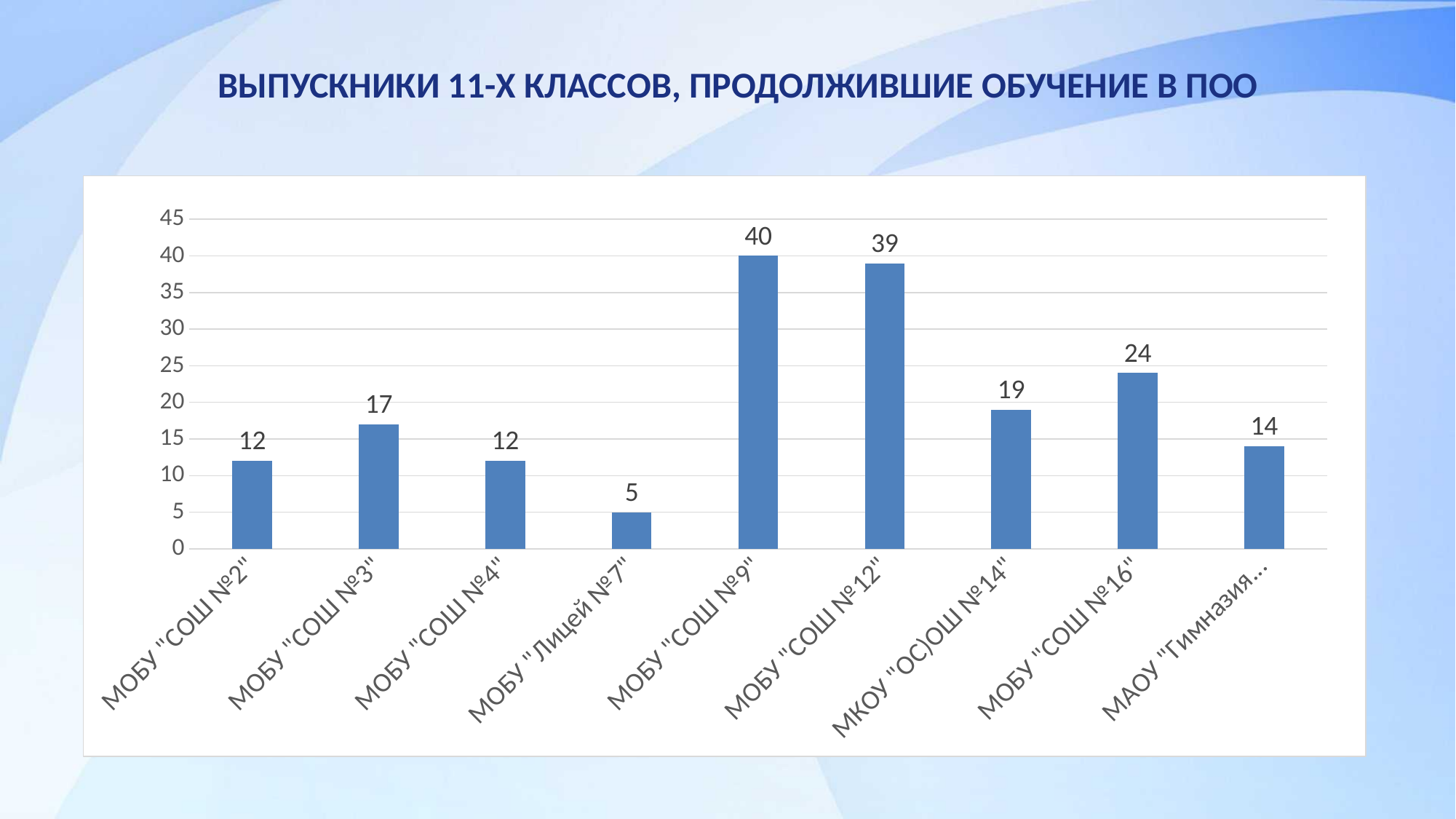
What is the value for МОБУ "СОШ №9"? 40 Which category has the lowest value? МОБУ "Лицей №7" What is the difference between the values for МОБУ "СОШ №9" and МОБУ "СОШ №12"? 1 Which is larger, the value for МОБУ "СОШ №3" or the value for МОБУ "СОШ №4"? МОБУ "СОШ №3" How many categories are shown on the chart? 9 Is the value for МОБУ "СОШ №12" greater or less than 35? greater What kind of chart is shown on the slide? bar chart What is the value for МОБУ "СОШ №16"? 24 What is the value for МОБУ "Лицей №7"? 5 Which category has the highest value? МОБУ "СОШ №9" What is the value for МКОУ "(ОС)ОШ №14"? 19 What is the difference between the values for МОБУ "СОШ №16" and МОБУ "СОШ №3"? 7